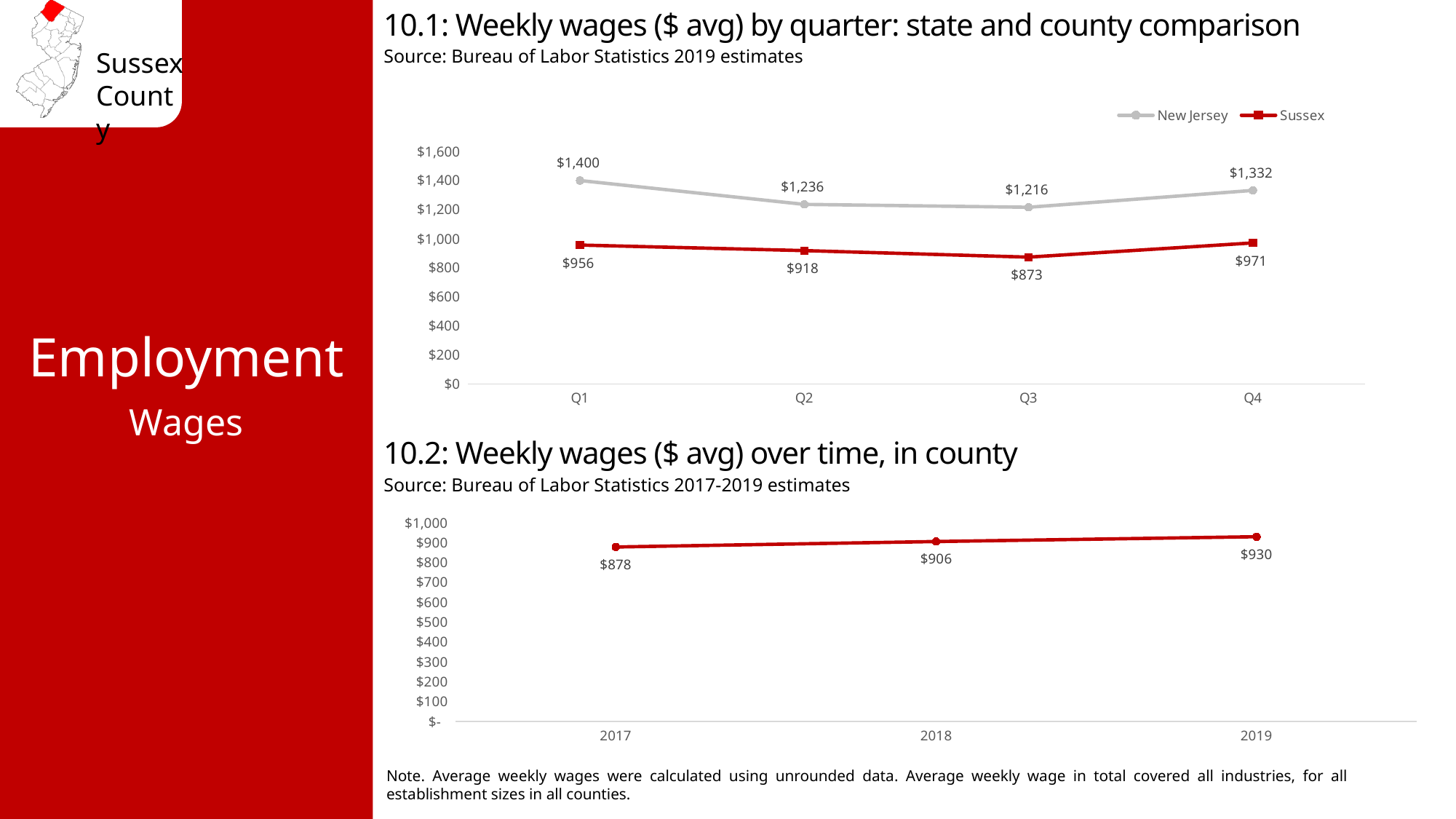
In chart 10.1, what is the difference between the New Jersey and Sussex weekly wages in Q4? $361 In chart 10.2, what is the weekly wage in 2018? $906 In chart 10.1, which quarter has the lowest Sussex weekly wage? Q3 In chart 10.1, how many series does the legend list? 2 In chart 10.2, what is the difference between the 2019 and 2017 weekly wages? $52 What kind of chart is chart 10.2? line chart In chart 10.1, how many quarters are plotted on the x axis? 4 In chart 10.1, what is the New Jersey weekly wage in Q1? $1,400 In chart 10.1, what is the Sussex weekly wage in Q3? $873 In chart 10.1, is the Sussex weekly wage in Q2 larger or smaller than in Q4? smaller In chart 10.2, do weekly wages rise or fall from 2017 to 2019? rise In chart 10.1, which quarter has the highest New Jersey weekly wage? Q1